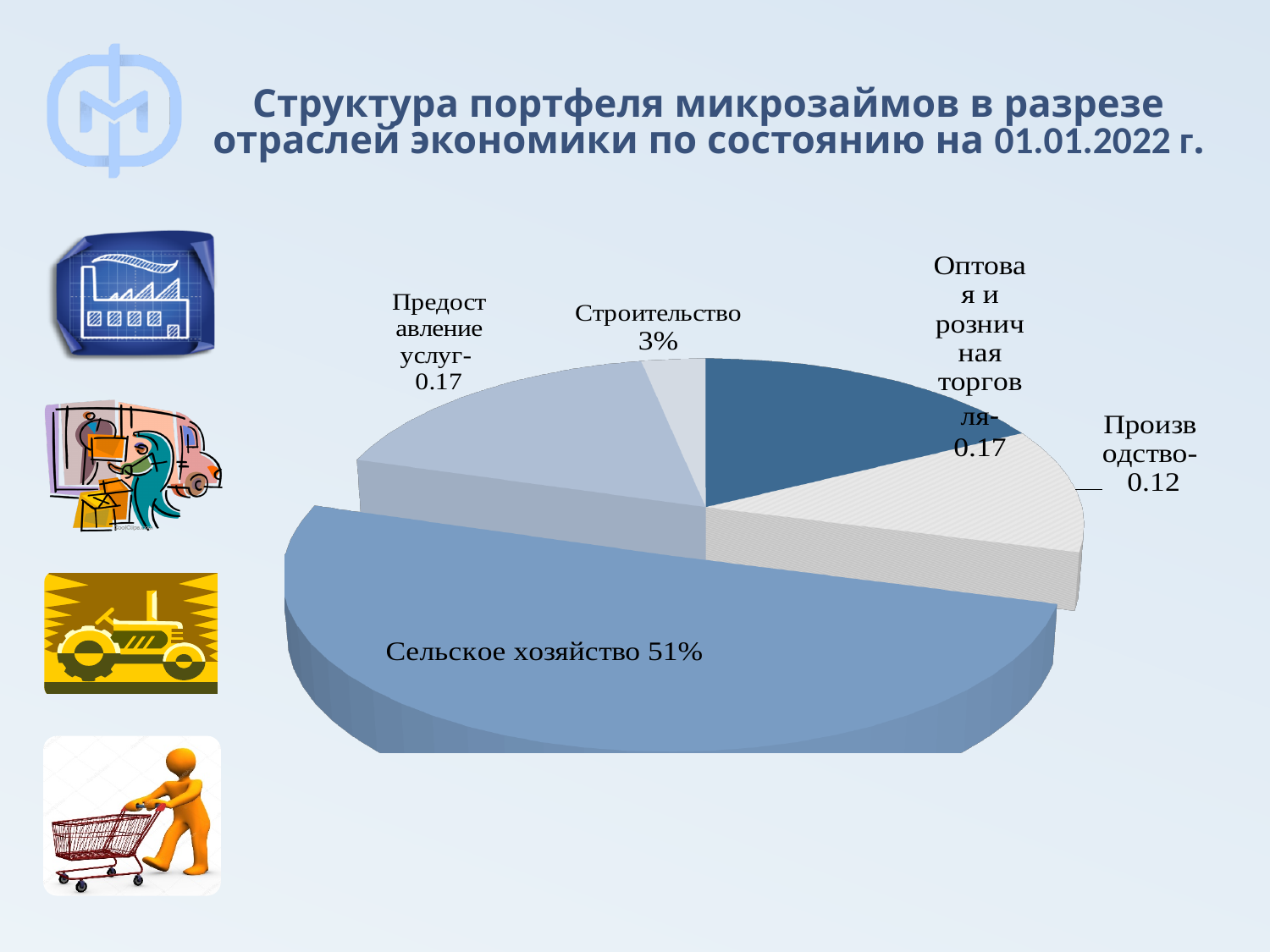
As of what date does the chart title say the portfolio structure is shown? 01.01.2022 Which sector has the largest slice of the pie? Сельское хозяйство What value is shown for Оптовая и розничная торговля? 0.17 Which is larger, the slice for Производство or the slice for Строительство? Производство What value is shown for Строительство? 3% What kind of chart is shown on the slide? Pie chart Which sector has the smallest slice of the pie? Строительство What value is shown for Предоставление услуг? 0.17 What share is shown for Сельское хозяйство? 51% What is the difference between the values for Предоставление услуг and Производство? 0.05 What value is shown for Производство? 0.12 How many sectors (slices) are shown in the pie chart? 5